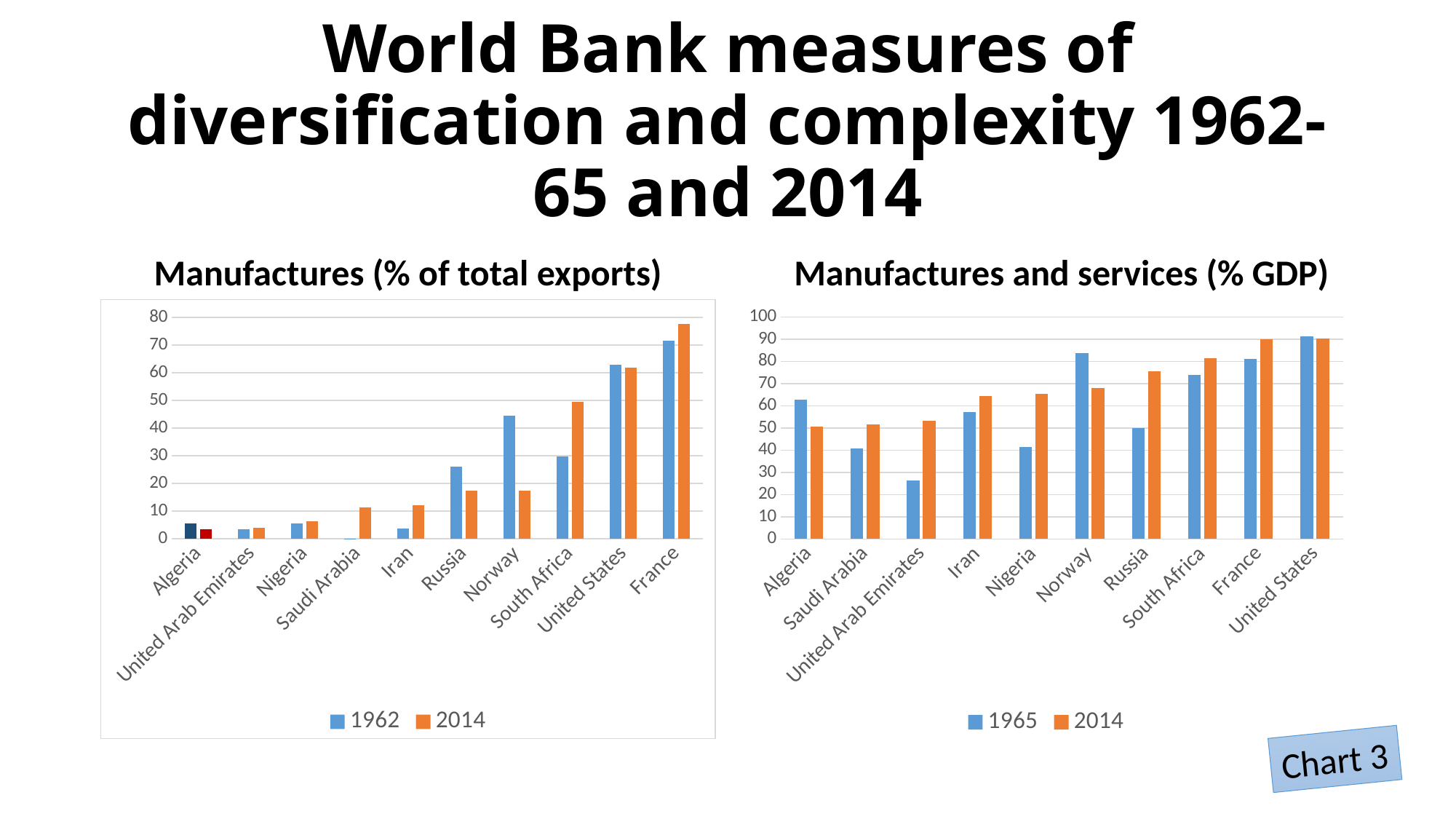
In the 'Manufactures (% of total exports)' chart, which country has the lowest value for 1962? Saudi Arabia In the 'Manufactures and services (% GDP)' chart, is the 2014 value for Russia greater or less than 70? greater How many countries are shown in the 'Manufactures (% of total exports)' chart? 10 How many series does the legend of the 'Manufactures and services (% GDP)' chart list? 2 In the 'Manufactures (% of total exports)' chart, is the 2014 value for Russia greater or less than 20? less In the 'Manufactures (% of total exports)' chart, which is larger for Norway: the 1962 value or the 2014 value? 1962 What kind of chart is the 'Manufactures (% of total exports)' chart? bar chart In the 'Manufactures and services (% GDP)' chart, which country has the highest value for 1965? United States In the 'Manufactures (% of total exports)' chart, is the 1962 value for Norway greater or less than 40? greater In the 'Manufactures and services (% GDP)' chart, which country has the lowest value for 1965? United Arab Emirates In the 'Manufactures and services (% GDP)' chart, which is larger for Algeria: the 1965 value or the 2014 value? 1965 In the 'Manufactures (% of total exports)' chart, which country has the highest value for 2014? France